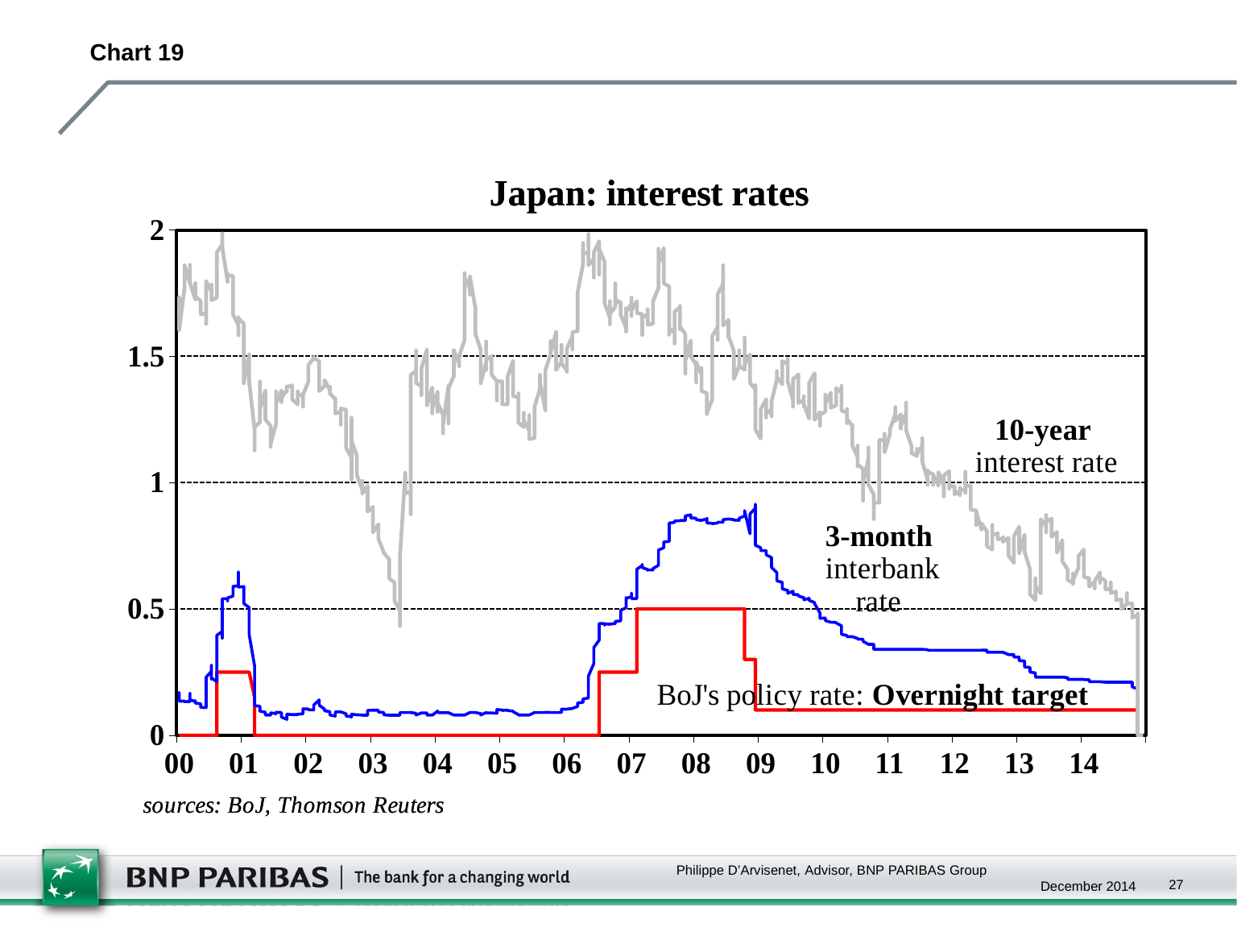
Which series has the highest values over the whole period? 10-year interest rate What kind of chart is shown on the slide? line chart How many year labels are shown on the x axis? 15 Is the 10-year interest rate at the start of 2000 greater or less than 1.5? greater Is the 3-month interbank rate during 2008 greater or less than 1? less Does the 10-year interest rate rise or fall between 2010 and 2014? fall Is the 3-month interbank rate during 2004 greater or less than 0.5? less What is the BoJ overnight target rate during 2008? 0.5 What is the title of the chart? Japan: interest rates Which is higher in 2008, the 10-year interest rate or the 3-month interbank rate? 10-year interest rate How many interest rate series are plotted on the chart? 3 What is the BoJ overnight target rate during 2004? 0